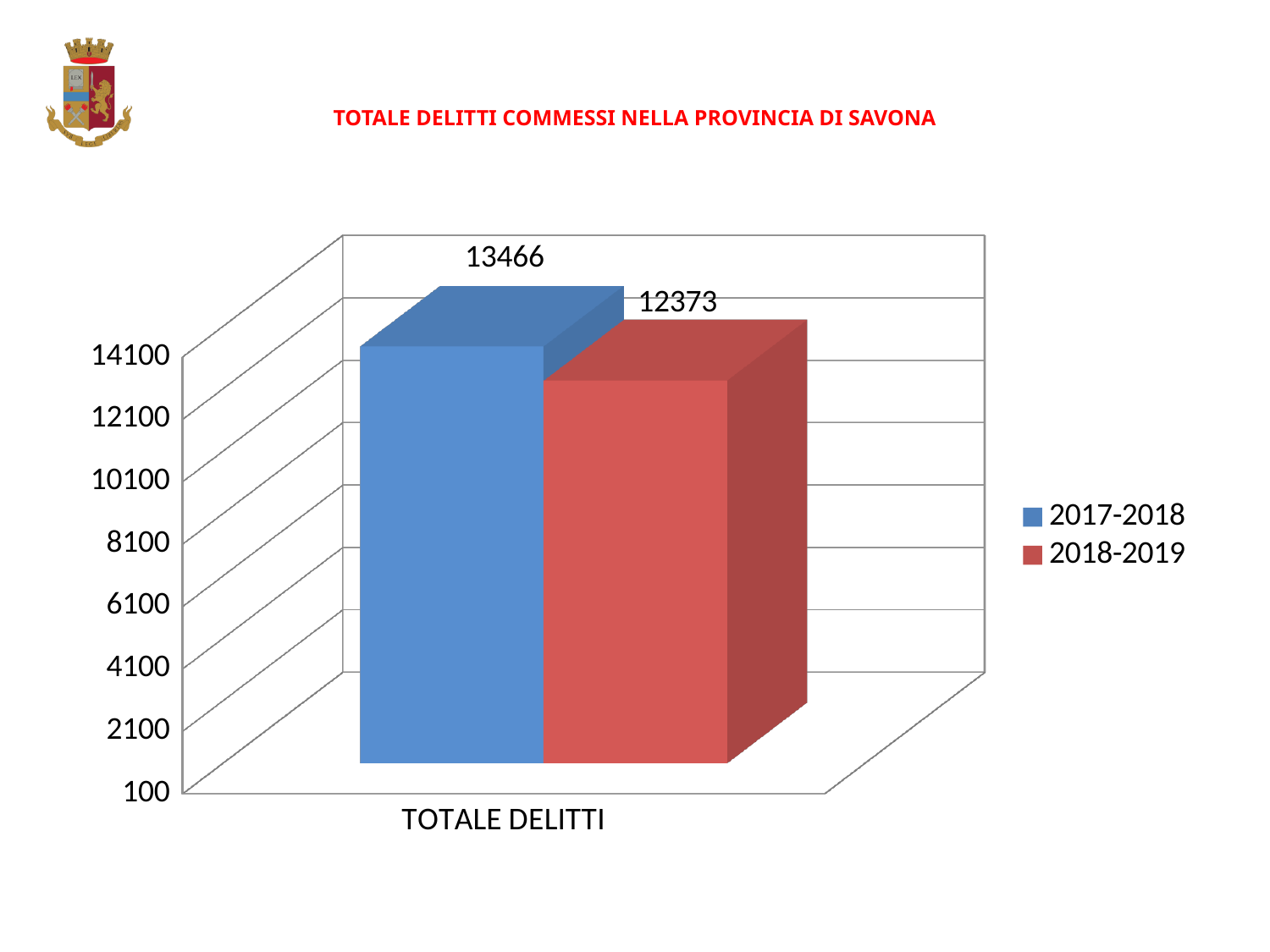
How many series does the legend list? 2 Which series has the lower value in the chart? 2018-2019 What kind of chart is shown on the slide? bar chart What is the value for 2018-2019 in the TOTALE DELITTI chart? 12373 What is the value for 2017-2018 in the TOTALE DELITTI chart? 13466 Is the value for 2017-2018 greater or less than 14100? less What is the title of the chart on the slide? TOTALE DELITTI COMMESSI NELLA PROVINCIA DI SAVONA Is the value for 2018-2019 greater or less than the value for 2017-2018? less What colour is the bar for 2018-2019? red What is the difference between the 2017-2018 value and the 2018-2019 value? 1093 Which series has the higher value, 2017-2018 or 2018-2019? 2017-2018 Is the value for 2018-2019 greater or less than 12100? greater